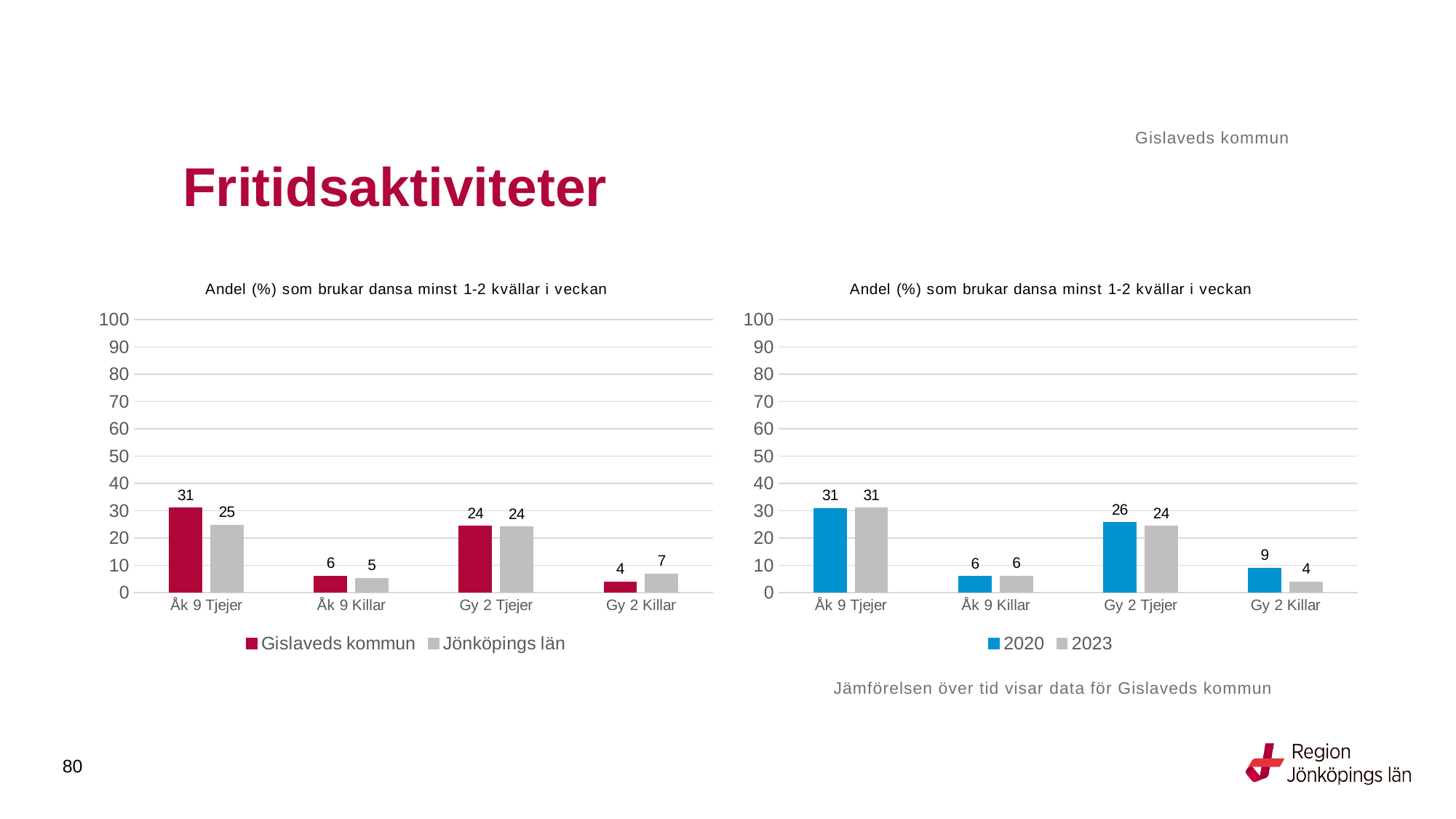
In the right chart, what is the 2023 value for Gy 2 Killar? 4 In the left chart, what is the value for Gislaveds kommun for Åk 9 Tjejer? 31 What type of chart is the right chart? Bar chart In the right chart, which is larger for Gy 2 Tjejer, the 2020 value or the 2023 value? 2020 In the right chart, what is the difference between the 2020 and 2023 values for Gy 2 Killar? 5 In the left chart, what is the difference between Gislaveds kommun and Jönköpings län for Åk 9 Tjejer? 6 In the right chart, what is the 2020 value for Gy 2 Tjejer? 26 In the left chart, what is the value for Jönköpings län for Gy 2 Killar? 7 How many categories are shown on the x axis of the right chart? 4 How many series does the legend of the left chart list? 2 In the left chart, which category has the highest value for Gislaveds kommun? Åk 9 Tjejer In the left chart, which category has the lowest value for Jönköpings län? Åk 9 Killar